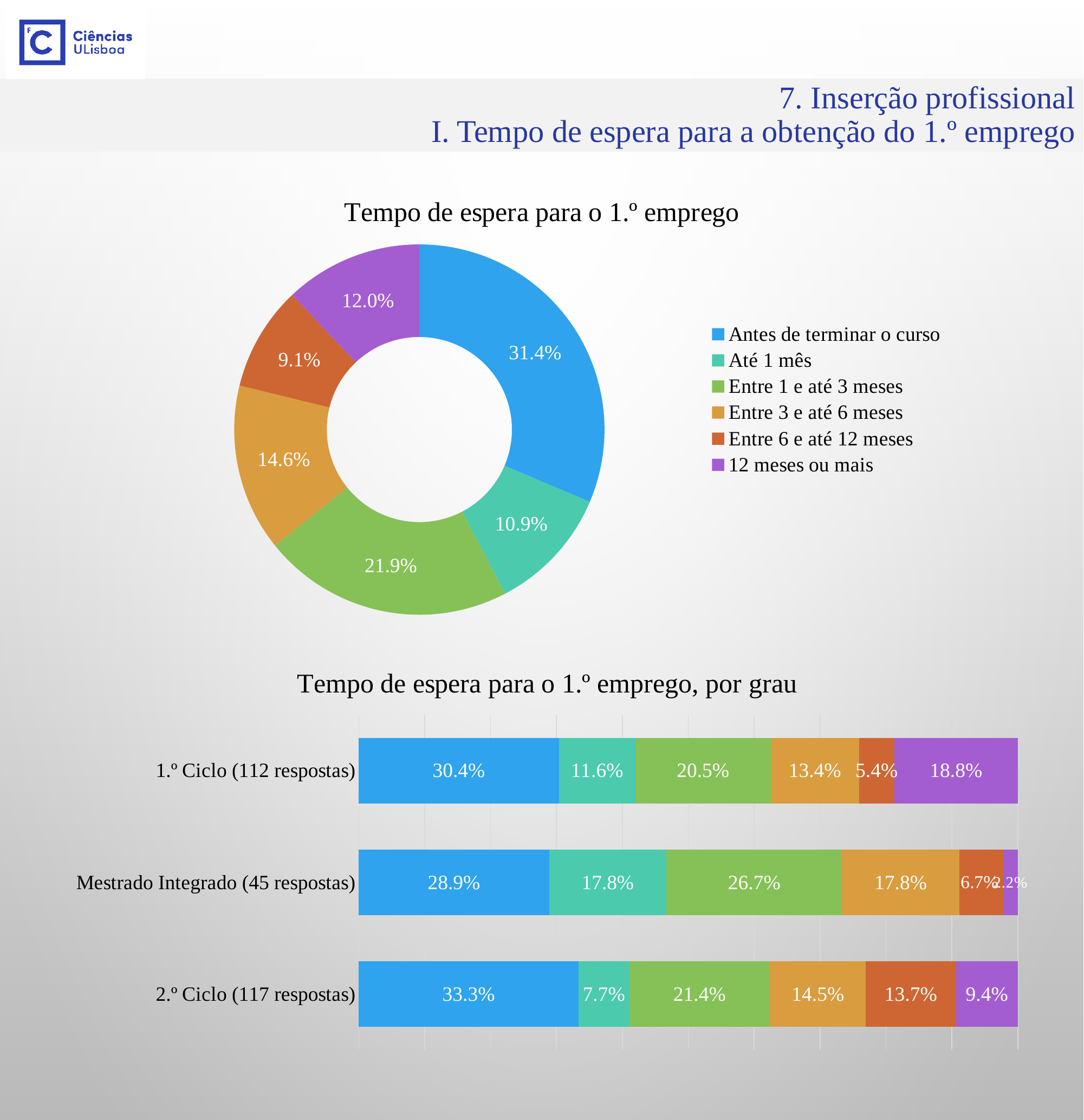
How many categories does the legend of the top doughnut chart list? 6 How many degree categories are shown in the bottom bar chart? 3 In the top doughnut chart, what is the share for "Antes de terminar o curso"? 31.4% In the bottom bar chart, what is the value of the first (blue) segment for "2.º Ciclo (117 respostas)"? 33.3% In the bottom bar chart, which degree has the larger green segment value: "Mestrado Integrado (45 respostas)" or "1.º Ciclo (112 respostas)"? Mestrado Integrado (45 respostas) In the bottom bar chart, what is the value of the last (purple) segment for "1.º Ciclo (112 respostas)"? 18.8% In the top doughnut chart, what is the difference between the shares for "Entre 1 e até 3 meses" and "Até 1 mês"? 11.0% What type of chart is the bottom chart titled "Tempo de espera para o 1.º emprego, por grau"? Stacked bar chart What type of chart is the top chart titled "Tempo de espera para o 1.º emprego"? Doughnut chart In the top doughnut chart, which category has the smallest share? Entre 6 e até 12 meses In the top doughnut chart, which category has the largest share? Antes de terminar o curso In the top doughnut chart, what is the share for "Entre 6 e até 12 meses"? 9.1%